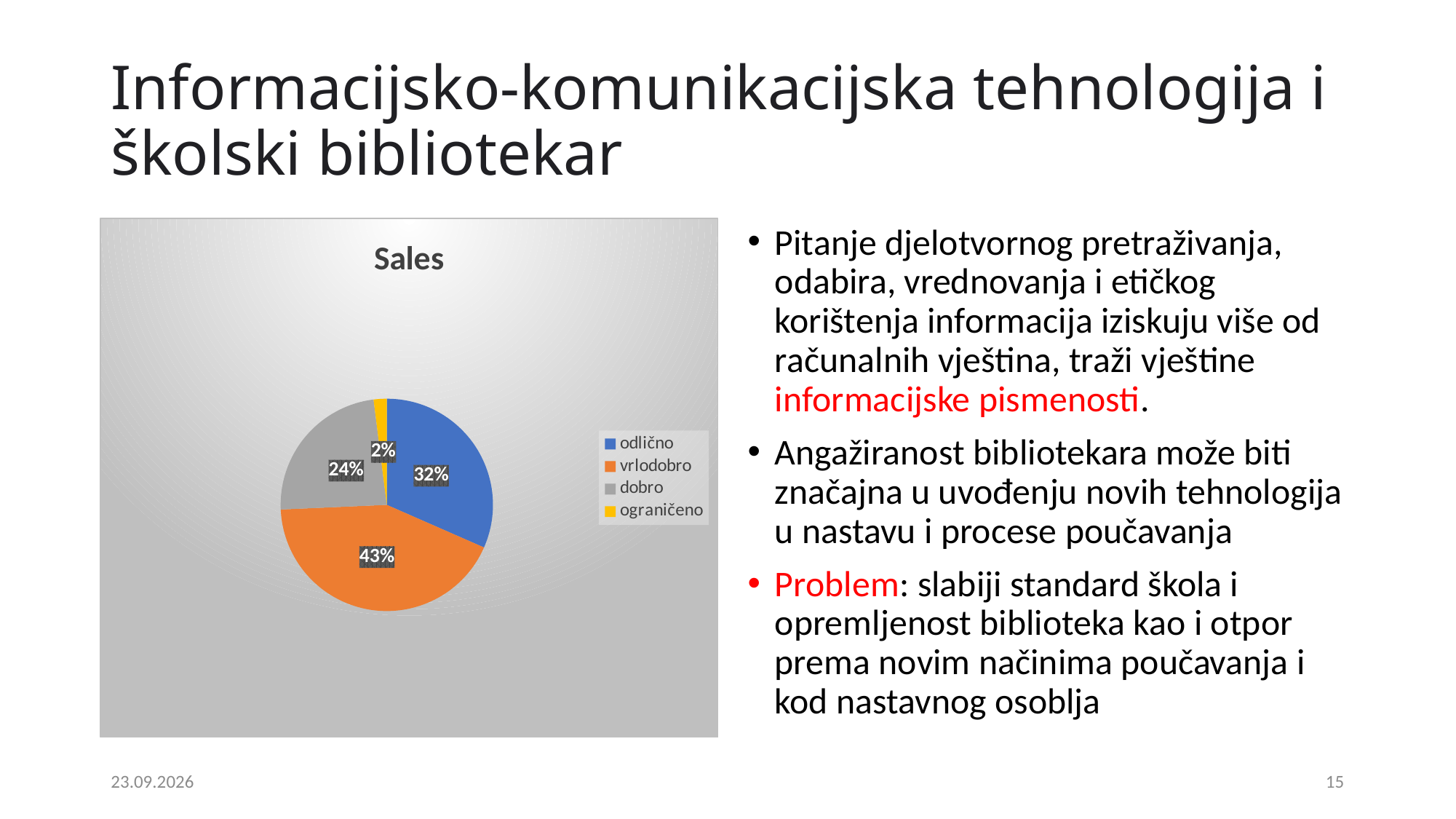
What colour is the 'dobro' slice in the pie chart? grey Which slice is larger, 'odlično' or 'dobro'? odlično Which category has the smallest slice of the pie? ograničeno How many categories does the pie chart have? 4 Which category has the largest slice of the pie? vrlodobro What is the title of the chart? Sales What share of the pie does the 'ograničeno' slice represent? 2% What share of the pie does the 'vrlodobro' slice represent? 43% What is the difference in percentage points between the 'vrlodobro' and 'odlično' slices? 11 What share of the pie does the 'dobro' slice represent? 24% What kind of chart is shown on the slide? pie chart